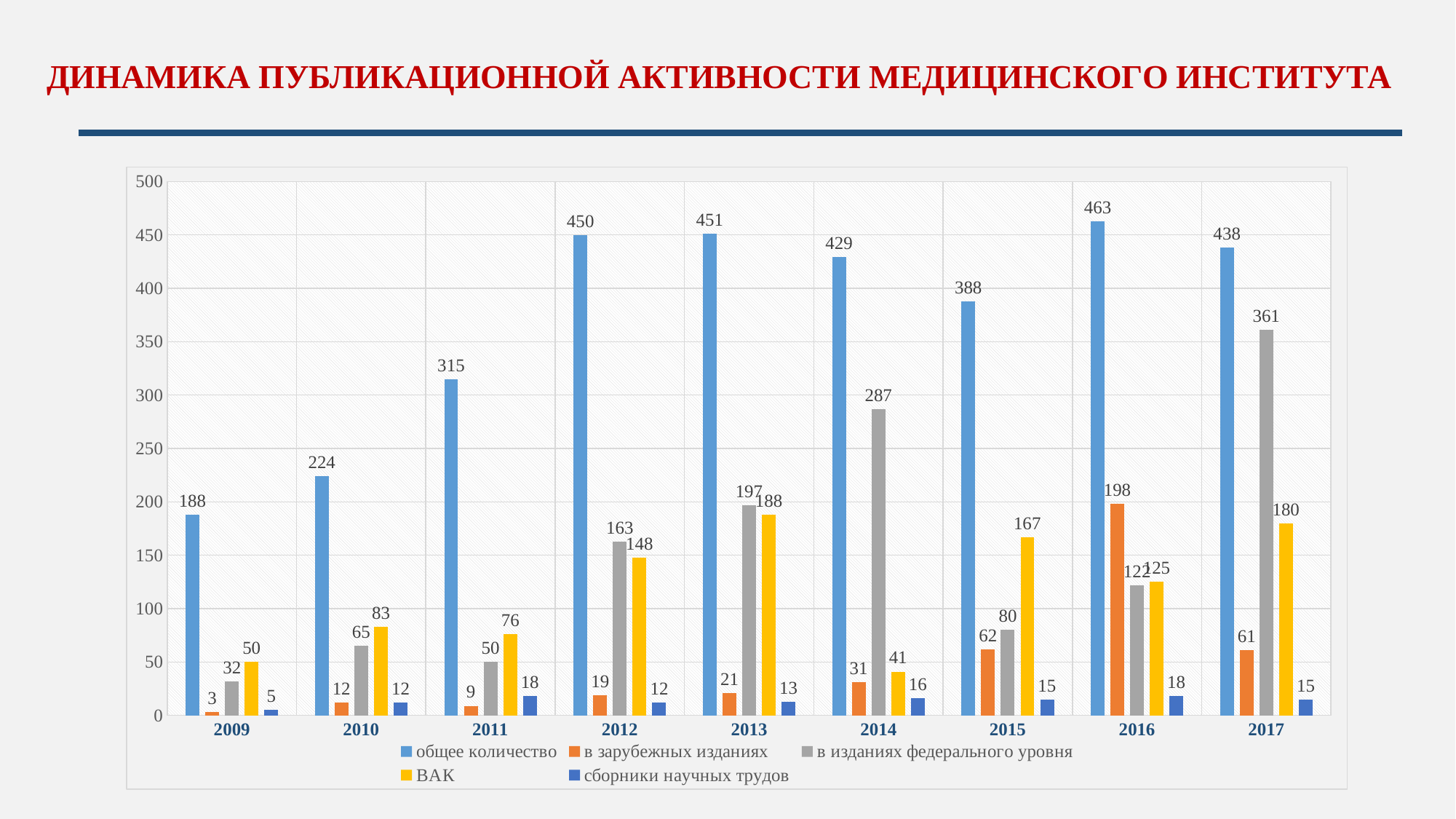
What kind of chart is shown on the slide? bar chart How many series does the legend list? 5 In which year is общее количество the highest? 2016 How many years are shown on the x axis? 9 What is the value of общее количество for 2016? 463 Does общее количество rise or fall from 2009 to 2012? rise What is the difference between ВАК in 2017 and ВАК in 2016? 55 What is the value of в зарубежных изданиях for 2016? 198 In 2015, which is larger: ВАК or в изданиях федерального уровня? ВАК Is the value of общее количество for 2011 greater or less than 300? greater What is the difference between в изданиях федерального уровня and ВАК in 2014? 246 In which year is общее количество the lowest? 2009